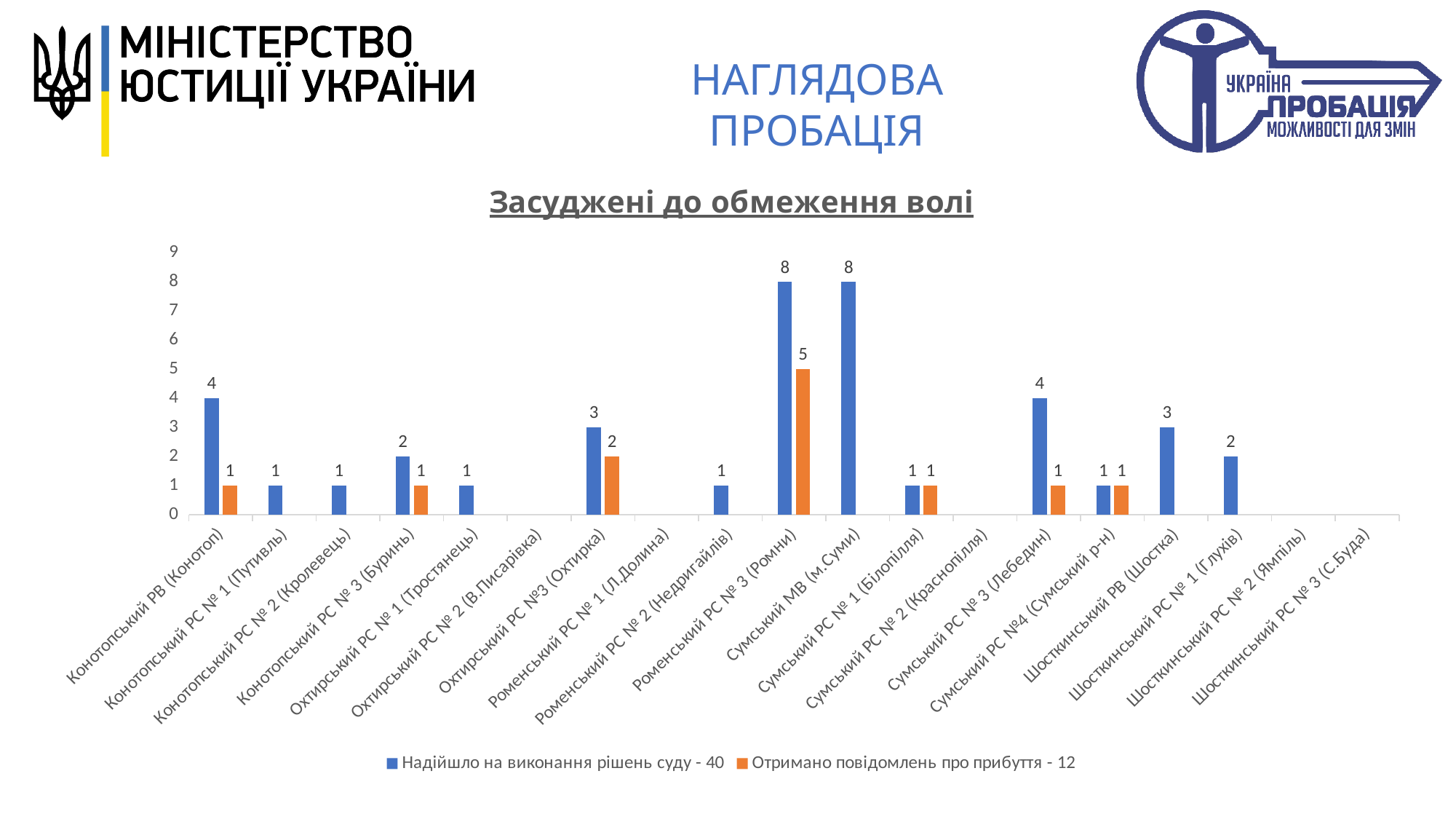
What is the value of 'Отримано повідомлень про прибуття' for Роменський РС № 3 (Ромни)? 5 What total is given in the legend for the series 'Надійшло на виконання рішень суду'? 40 Which is larger for Конотопський РВ (Конотоп): 'Надійшло на виконання рішень суду' or 'Отримано повідомлень про прибуття'? Надійшло на виконання рішень суду What is the value of 'Надійшло на виконання рішень суду' for Роменський РС № 3 (Ромни)? 8 What is the value of 'Надійшло на виконання рішень суду' for Сумський РС № 3 (Лебедин)? 4 What is the value of 'Надійшло на виконання рішень суду' for Шосткинський РВ (Шостка)? 3 What is the difference between 'Надійшло на виконання рішень суду' and 'Отримано повідомлень про прибуття' for Охтирський РС №3 (Охтирка)? 1 What type of chart is shown on the slide? bar chart How many categories are shown on the x axis? 19 What is the title of the chart? Засуджені до обмеження волі Which category has the highest value for 'Отримано повідомлень про прибуття'? Роменський РС № 3 (Ромни) How many series does the legend list? 2